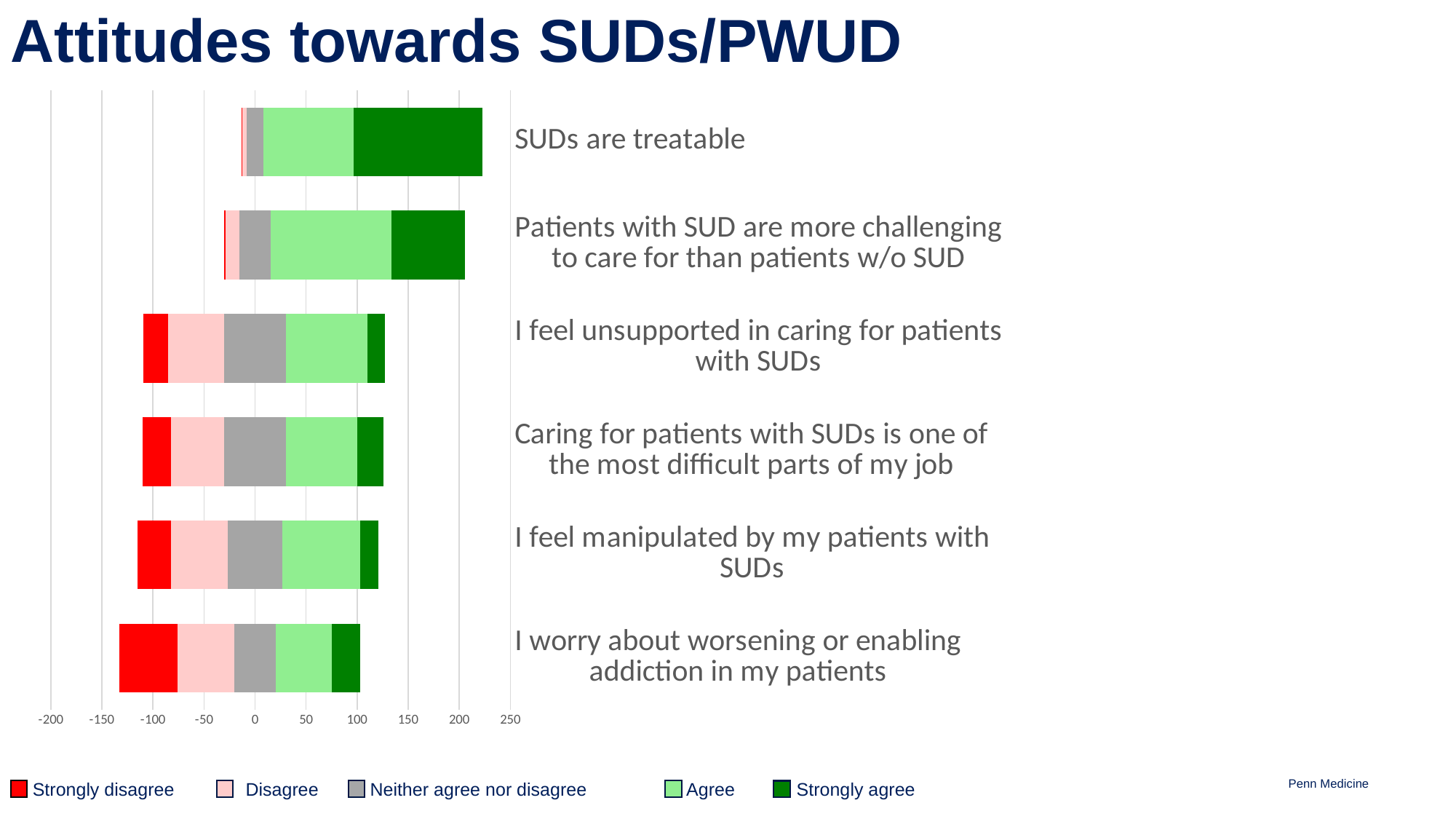
How many statements (categories) are plotted in the chart? 6 Is the right end of the bar for 'SUDs are treatable' greater or less than 200? greater What is the title of the slide? Attitudes towards SUDs/PWUD Is the left end of the bar for 'I worry about worsening or enabling addiction in my patients' greater or less than -100? less Is the right end of the bar for 'I worry about worsening or enabling addiction in my patients' greater or less than 150? less Which legend entry is shown in dark green? Strongly agree Which statement has the largest 'Strongly agree' segment? SUDs are treatable Which statement has the smallest 'Strongly disagree' segment? SUDs are treatable How many series does the legend list? 5 Which statement has the largest 'Strongly disagree' segment? I worry about worsening or enabling addiction in my patients What kind of chart is shown on the slide? bar chart